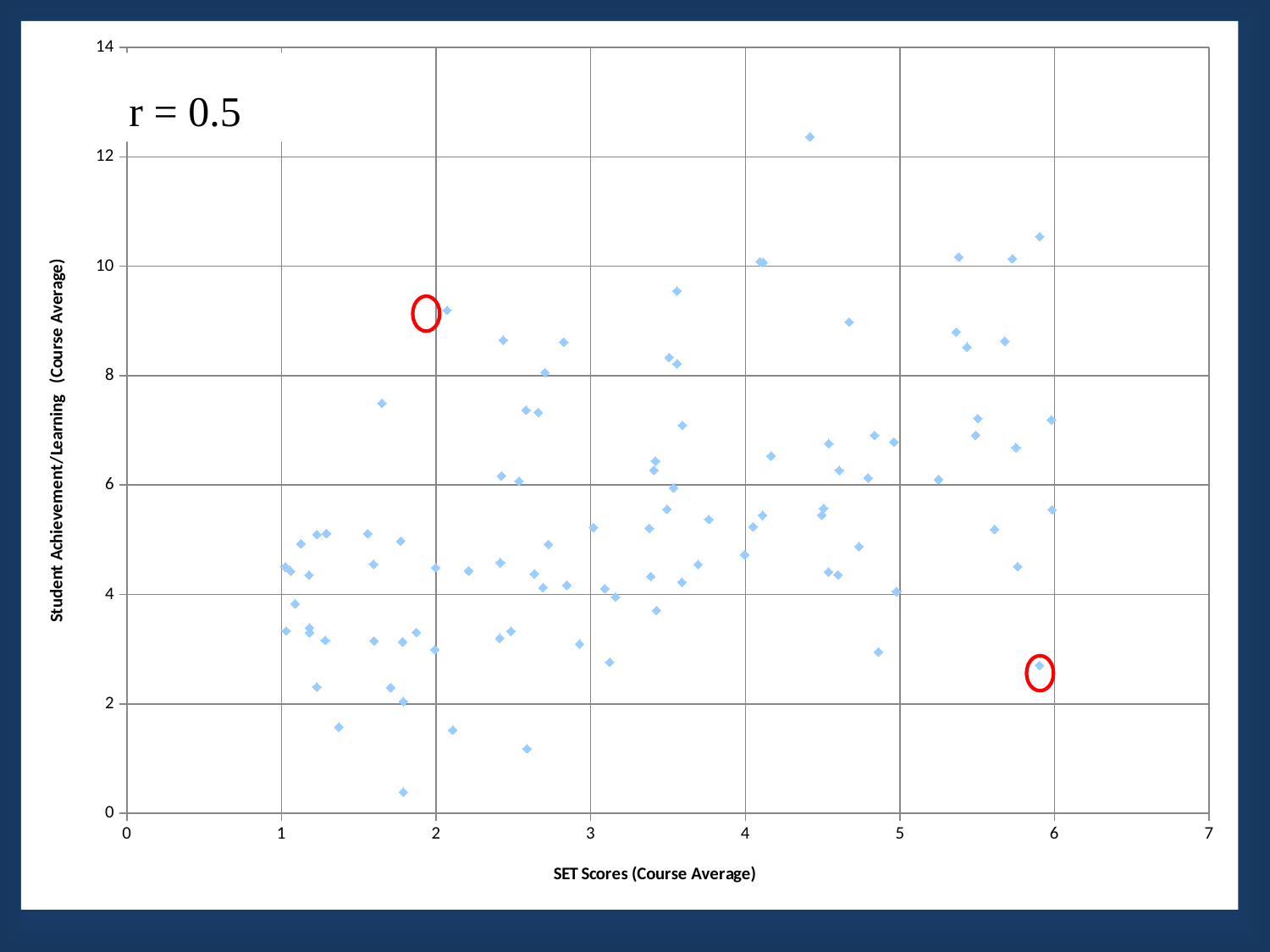
Do the Student Achievement/Learning values generally rise or fall as SET Scores increase along the x axis? rise Is the Student Achievement/Learning value of the lowest point on the chart greater or less than 2? less Is the Student Achievement/Learning value of the highest point on the chart greater or less than 12? greater What is the title of the x axis of the chart? SET Scores (Course Average) Is the SET Score of the lowest point on the chart greater or less than 2? less What correlation coefficient (r) is printed on the chart? r = 0.5 What kind of chart is shown on the slide? scatter plot